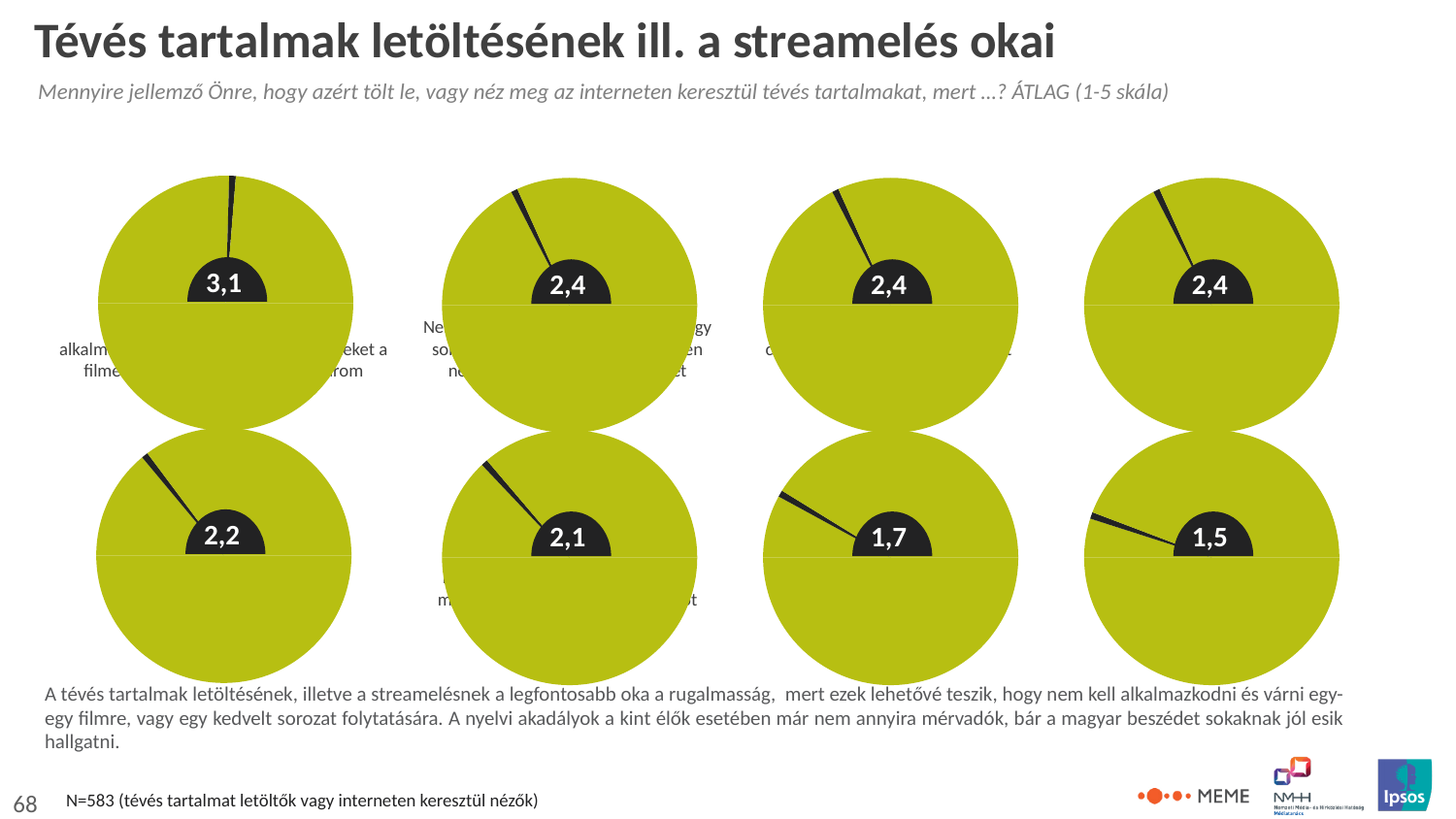
How many pie charts are shown on the slide? 8 What value is shown on the top-left pie chart? 3,1 What value is shown on the bottom-right pie chart? 1,5 How many of the pie charts on the slide show the value 2,4? 3 What type of chart is used on the slide? Pie chart What value is shown on the third pie chart from the left in the bottom row? 1,7 What value is shown on the bottom-left pie chart? 2,2 Which pie chart on the slide shows the highest value? The top-left one (3,1) Which pie chart on the slide shows the lowest value? The bottom-right one (1,5) What value is shown on the second pie chart from the left in the bottom row? 2,1 Which is larger: the value on the bottom-left pie chart or the value on the third pie chart in the bottom row? The bottom-left pie chart (2,2) What is the difference between the value on the top-left pie chart and the value on the bottom-right pie chart? 1,6